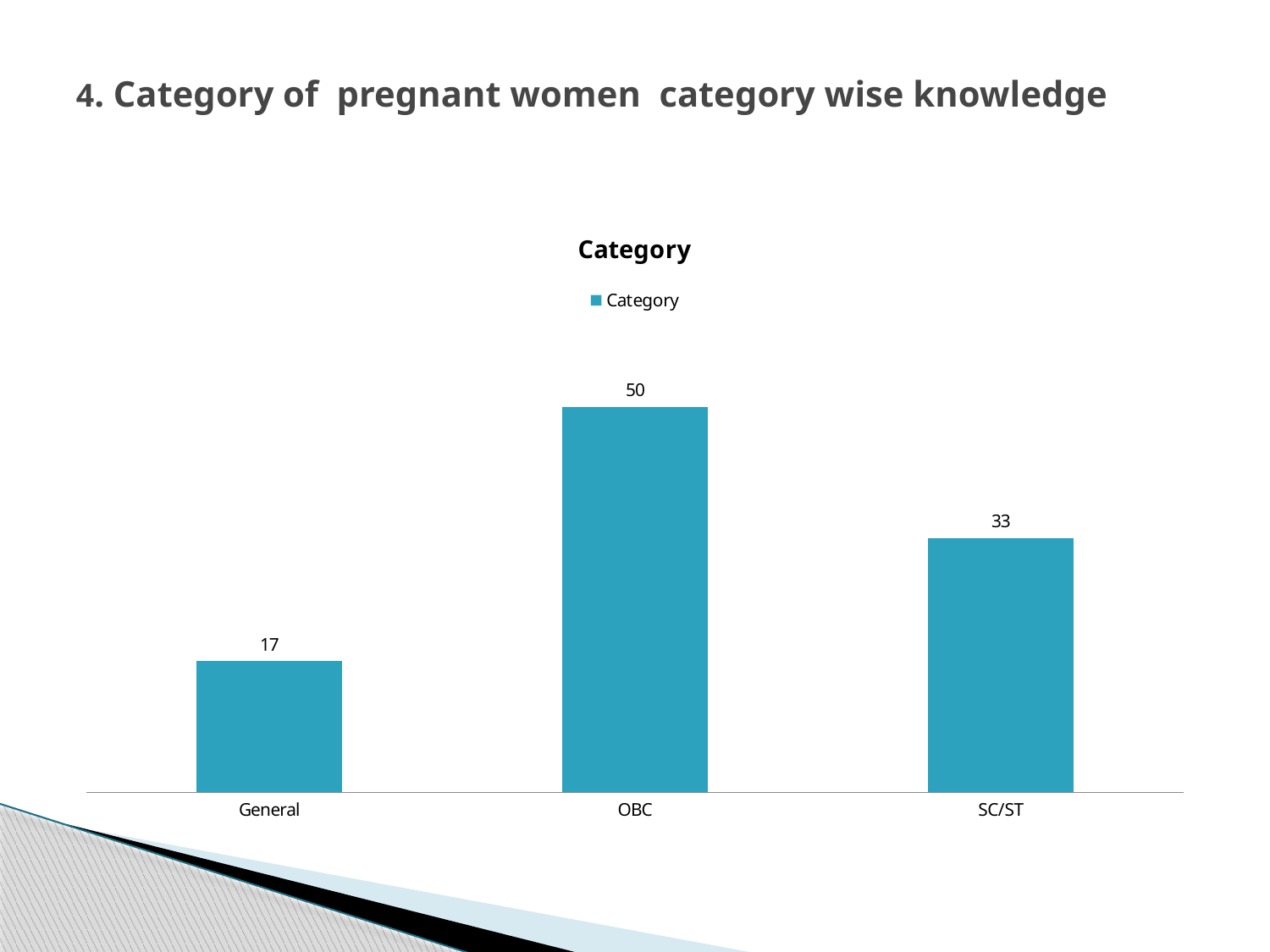
What is the value for SC/ST? 33 What kind of chart is shown on the slide? Bar chart What is the difference between the values for OBC and SC/ST? 17 Which category has the highest value? OBC How many categories are shown on the x axis? 3 What is the value for General? 17 What is the difference between the values for SC/ST and General? 16 How many series does the legend list? 1 What is the title of the chart? Category Which is larger, the value for General or the value for SC/ST? SC/ST Which category has the lowest value? General What is the value for OBC? 50